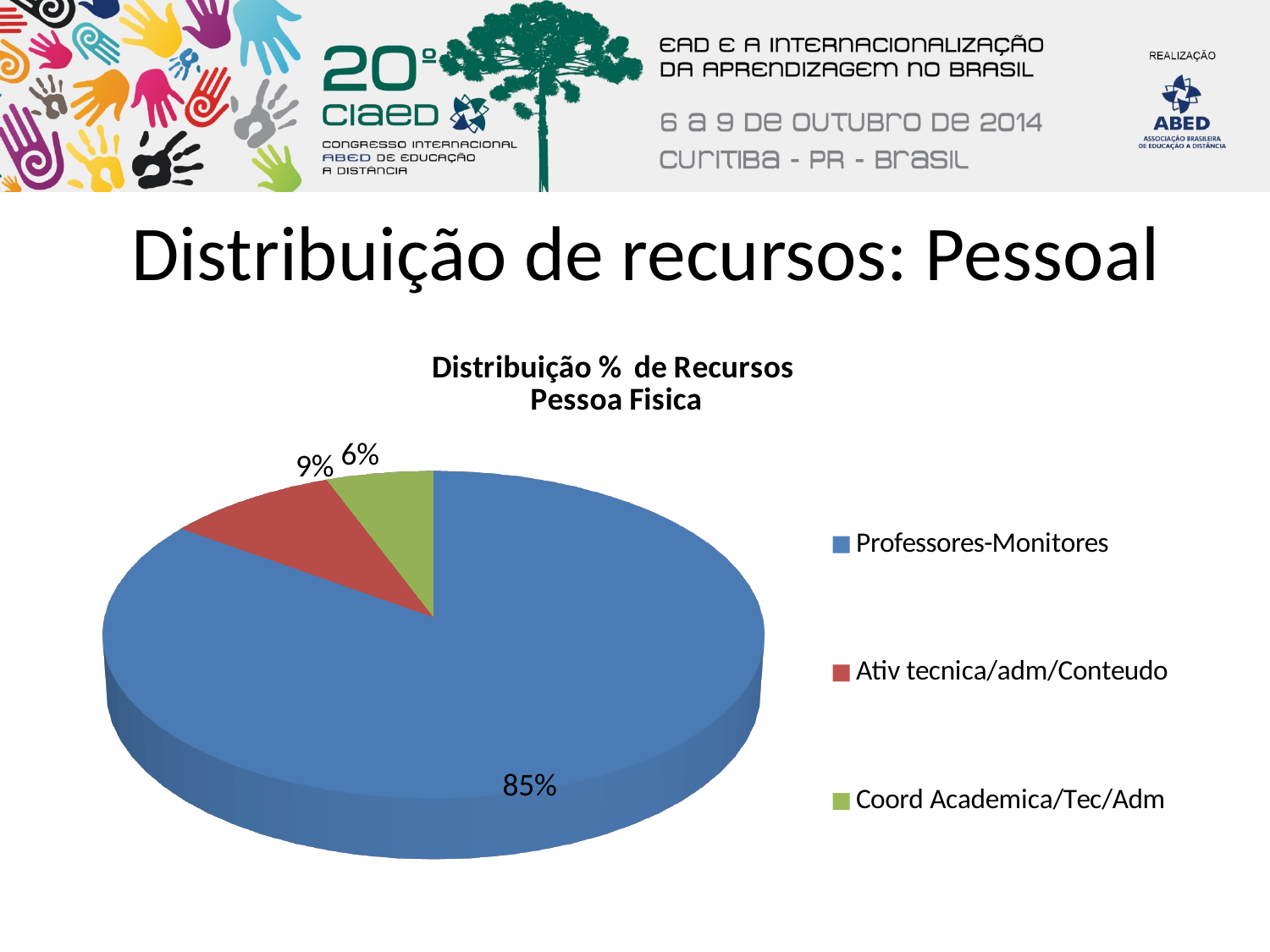
Which category has the largest share of the pie? Professores-Monitores What percentage of resources goes to Professores-Monitores? 85% What percentage of resources goes to Coord Academica/Tec/Adm? 6% What percentage of resources goes to Ativ tecnica/adm/Conteudo? 9% What type of chart is shown on the slide? Pie chart What is the difference in percentage points between Professores-Monitores and Ativ tecnica/adm/Conteudo? 76 How many categories does the pie chart show? 3 What colour is the slice for Professores-Monitores? Blue Which category has the smallest share of the pie? Coord Academica/Tec/Adm Which is larger: the share for Ativ tecnica/adm/Conteudo or for Coord Academica/Tec/Adm? Ativ tecnica/adm/Conteudo What is the title of the chart? Distribuição % de Recursos Pessoa Fisica What is the difference in percentage points between Ativ tecnica/adm/Conteudo and Coord Academica/Tec/Adm? 3